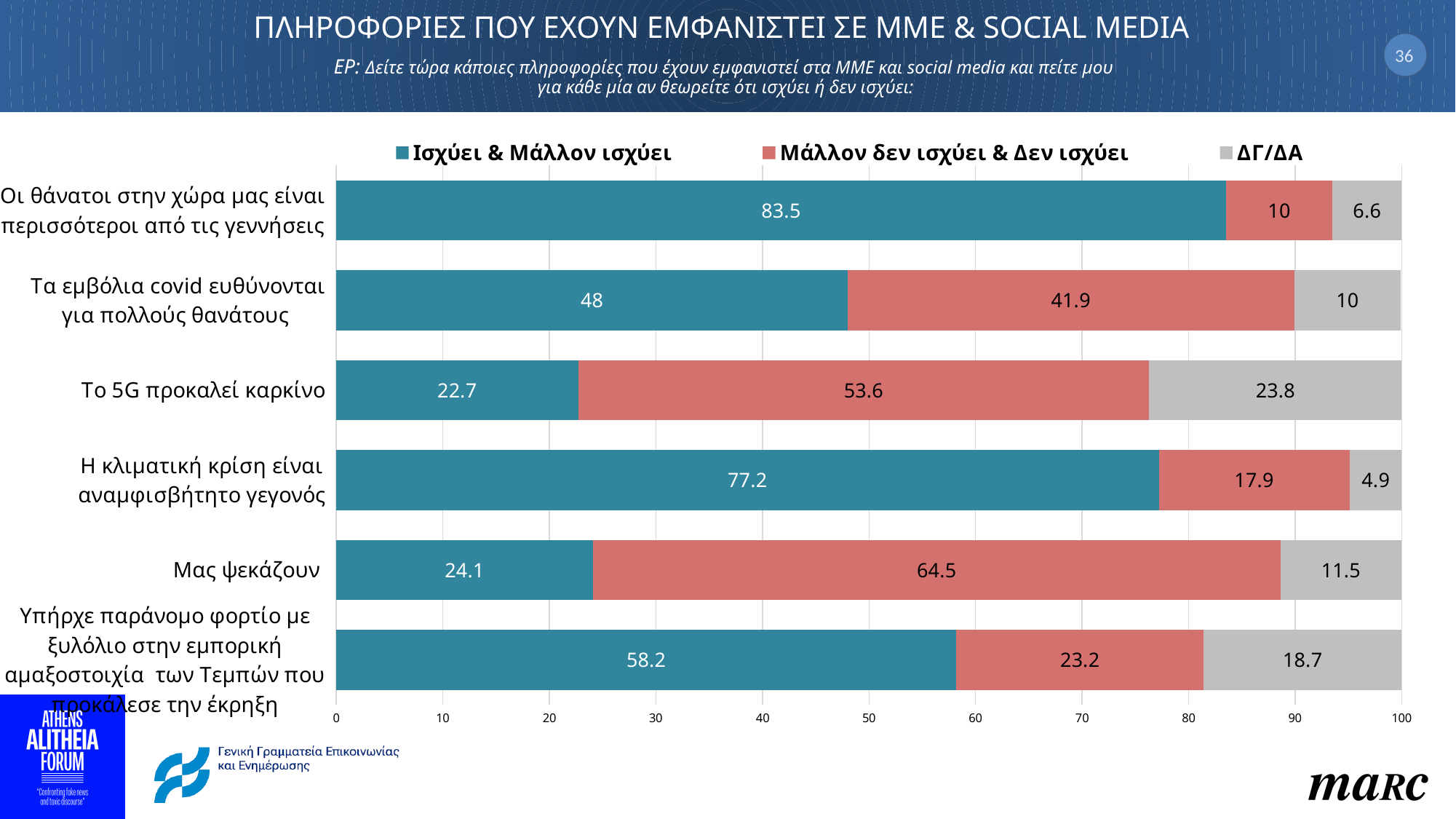
What is the total of the stacked bar for 'Η κλιματική κρίση είναι αναμφισβήτητο γεγονός'? 100 What is the value of 'Ισχύει & Μάλλον ισχύει' for 'Το 5G προκαλεί καρκίνο'? 22.7 Which statement has the lowest 'ΔΓ/ΔΑ' value? Η κλιματική κρίση είναι αναμφισβήτητο γεγονός How many statements (categories) are plotted in the chart? 6 What is the value of 'Μάλλον δεν ισχύει & Δεν ισχύει' for 'Μας ψεκάζουν'? 64.5 What kind of chart is shown on the slide? Stacked bar chart What colour represents the 'ΔΓ/ΔΑ' series in the chart? Grey What is the 'ΔΓ/ΔΑ' value for 'Η κλιματική κρίση είναι αναμφισβήτητο γεγονός'? 4.9 How many series does the legend list? 3 What is the difference between the 'Ισχύει & Μάλλον ισχύει' and 'Μάλλον δεν ισχύει & Δεν ισχύει' values for 'Τα εμβόλια covid ευθύνονται για πολλούς θανάτους'? 6.1 Which statement has the highest 'Ισχύει & Μάλλον ισχύει' value? Οι θάνατοι στην χώρα μας είναι περισσότεροι από τις γεννήσεις Which is larger: the 'ΔΓ/ΔΑ' value for 'Το 5G προκαλεί καρκίνο' or for 'Μας ψεκάζουν'? Το 5G προκαλεί καρκίνο